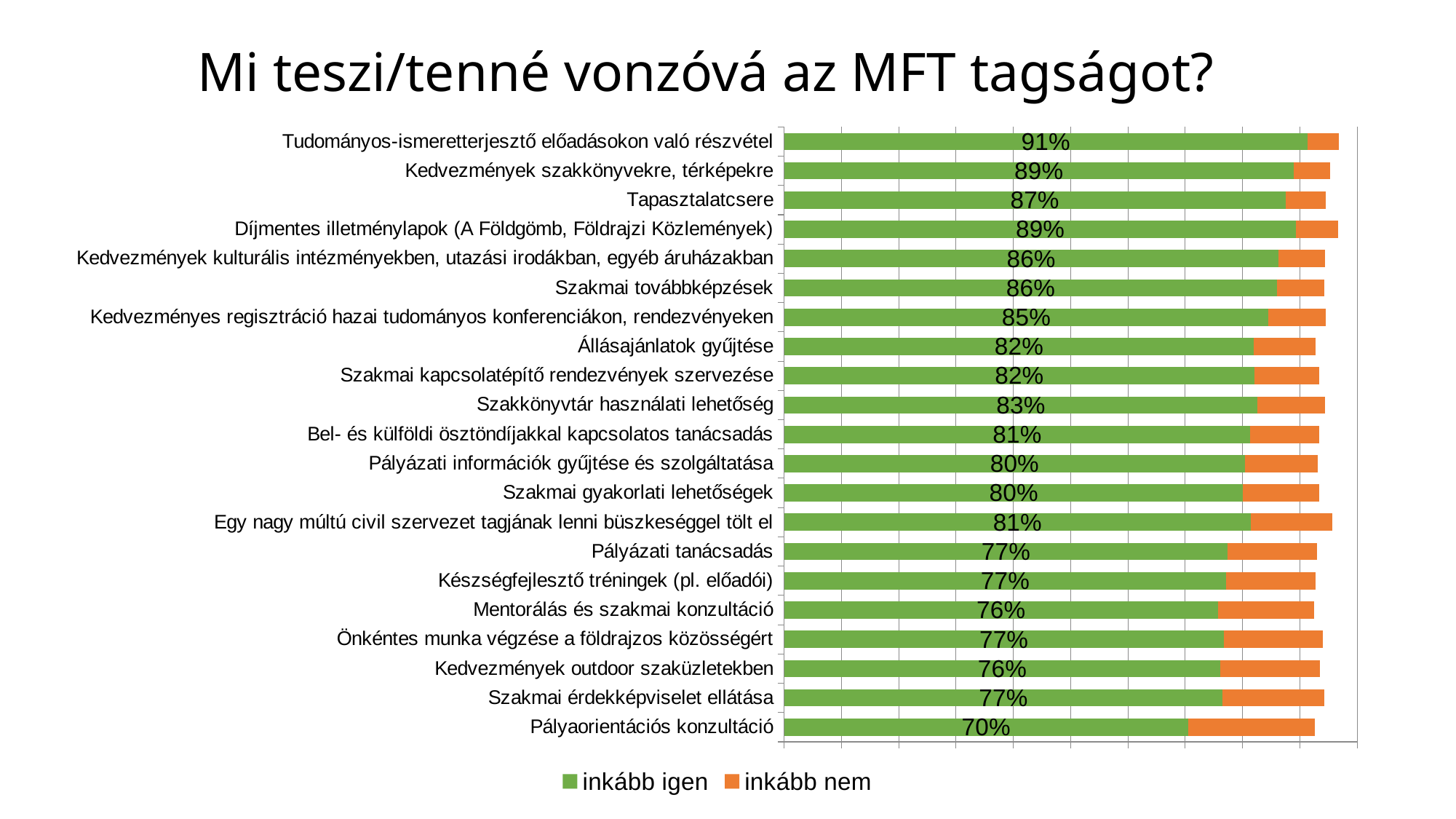
What is the 'inkább igen' value for 'Tapasztalatcsere'? 87% Which category has the lowest 'inkább igen' value? Pályaorientációs konzultáció How many categories are shown in the chart? 21 What is the 'inkább igen' value for 'Pályaorientációs konzultáció'? 70% What is the 'inkább igen' value for 'Szakkönyvtár használati lehetőség'? 83% What is the difference between the 'inkább igen' values for 'Tudományos-ismeretterjesztő előadásokon való részvétel' and 'Pályaorientációs konzultáció'? 21% Which category has the highest 'inkább igen' value? Tudományos-ismeretterjesztő előadásokon való részvétel Which has a higher 'inkább igen' value: 'Állásajánlatok gyűjtése' or 'Pályázati tanácsadás'? Állásajánlatok gyűjtése How many series does the legend list? 2 What is the 'inkább igen' value for 'Mentorálás és szakmai konzultáció'? 76% What is the title of the slide? Mi teszi/tenné vonzóvá az MFT tagságot? What type of chart is shown on the slide? Stacked bar chart